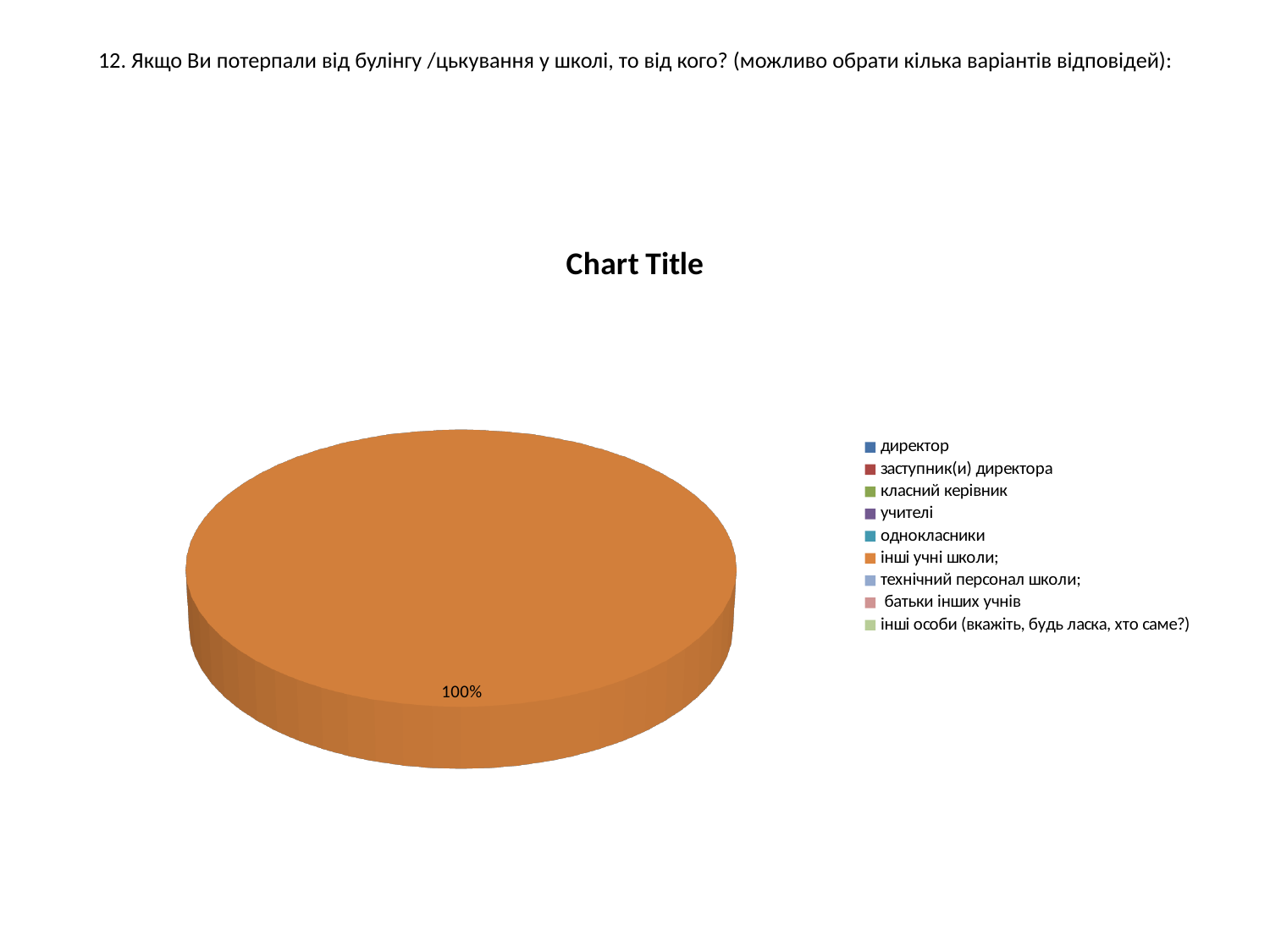
What is the value shown on the data label of the pie slice? 100% Is the share for інші учні школи; greater or less than 50%? greater What colour is the slice that makes up the whole pie? orange Which category has the largest share of the pie? інші учні школи; Which legend category does the single visible slice of the pie correspond to? інші учні школи; How many slices are visible in the pie? 1 What is the title printed above the chart? Chart Title How many entries does the legend list? 9 What kind of chart is shown on the slide? pie chart What share of the pie does the slice labelled 100% represent? 100%